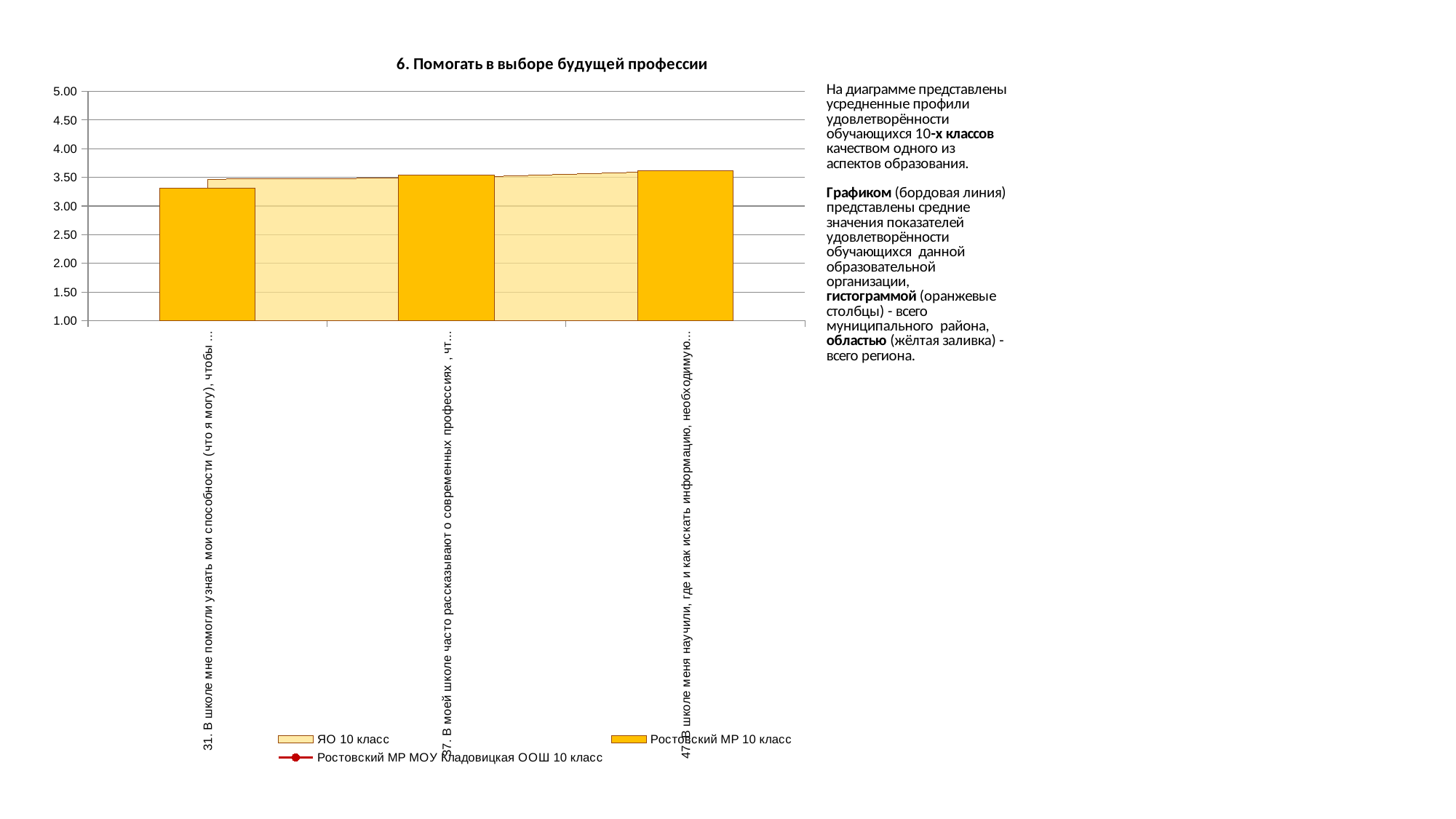
For which question is the orange bar (Ростовский МР 10 класс) the lowest? 31 Which legend entry corresponds to the orange bars? Ростовский МР 10 класс Is the orange bar (Ростовский МР 10 класс) for question 31 greater or less than 3.50? less How many categories (questions) are plotted along the x axis? 3 Is the orange bar (Ростовский МР 10 класс) for question 31 greater or less than 3.00? greater Which orange bar (Ростовский МР 10 класс) is larger: question 31 or question 47? question 47 What kind of chart is shown on the slide? bar chart (with an area series) How many series does the legend list? 3 Do the orange bars (Ростовский МР 10 класс) rise or fall from question 31 to question 47? rise What is the title of the chart? 6. Помогать в выборе будущей профессии Is the orange bar (Ростовский МР 10 класс) for question 47 greater or less than 3.50? greater